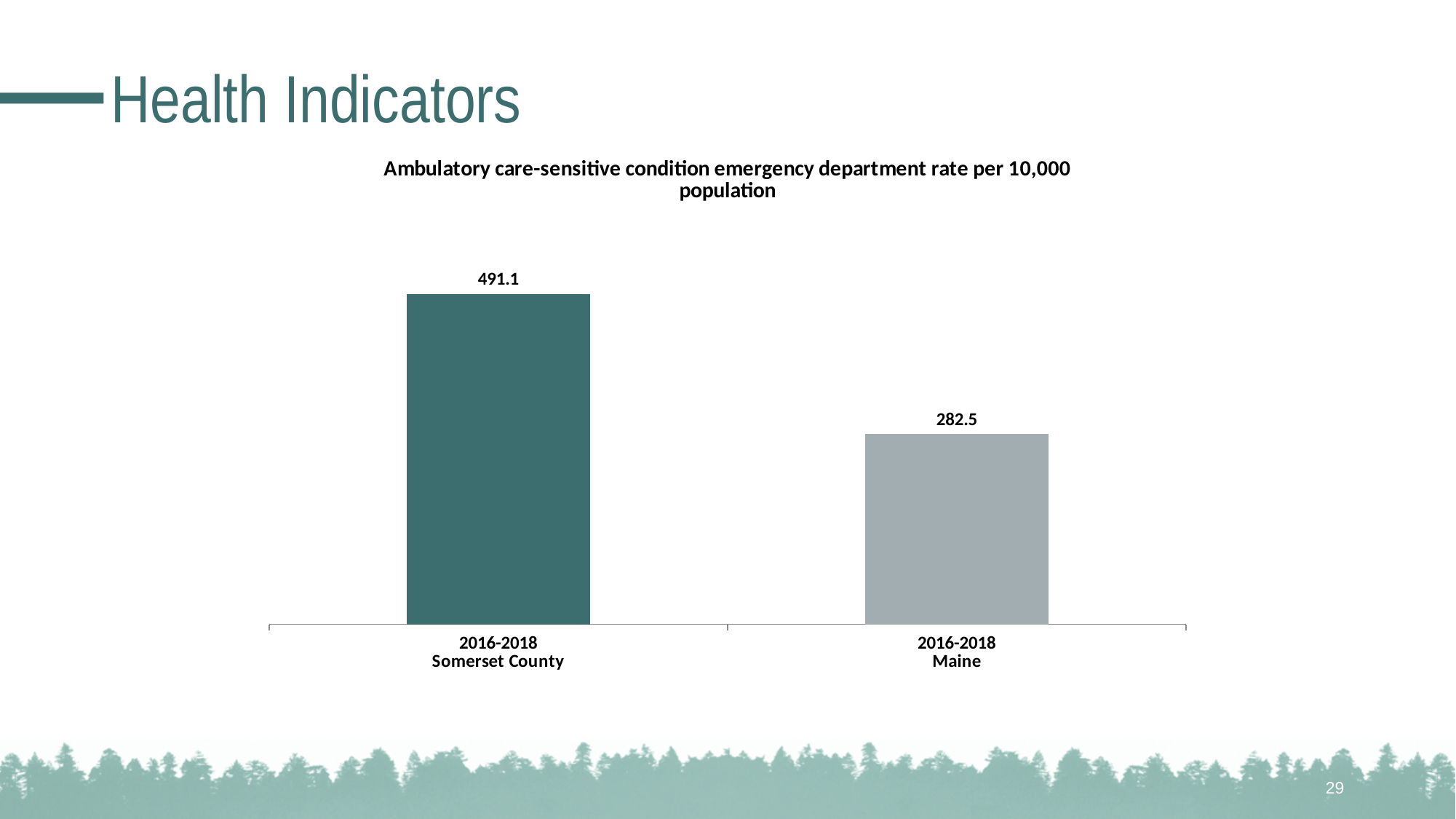
What time period do both bars on the chart cover? 2016-2018 Which category has the higher ambulatory care-sensitive condition emergency department rate, Somerset County or Maine? Somerset County What is the ambulatory care-sensitive condition emergency department rate per 10,000 population for Somerset County (2016-2018)? 491.1 Which category has the lowest ambulatory care-sensitive condition emergency department rate on the chart? Maine What is the ambulatory care-sensitive condition emergency department rate per 10,000 population for Maine (2016-2018)? 282.5 What is the title of the chart? Ambulatory care-sensitive condition emergency department rate per 10,000 population What is the difference between the Somerset County rate and the Maine rate? 208.6 Is the rate for Maine larger or smaller than the rate for Somerset County? smaller How many bars are shown on the chart? 2 What kind of chart is shown on the slide? bar chart